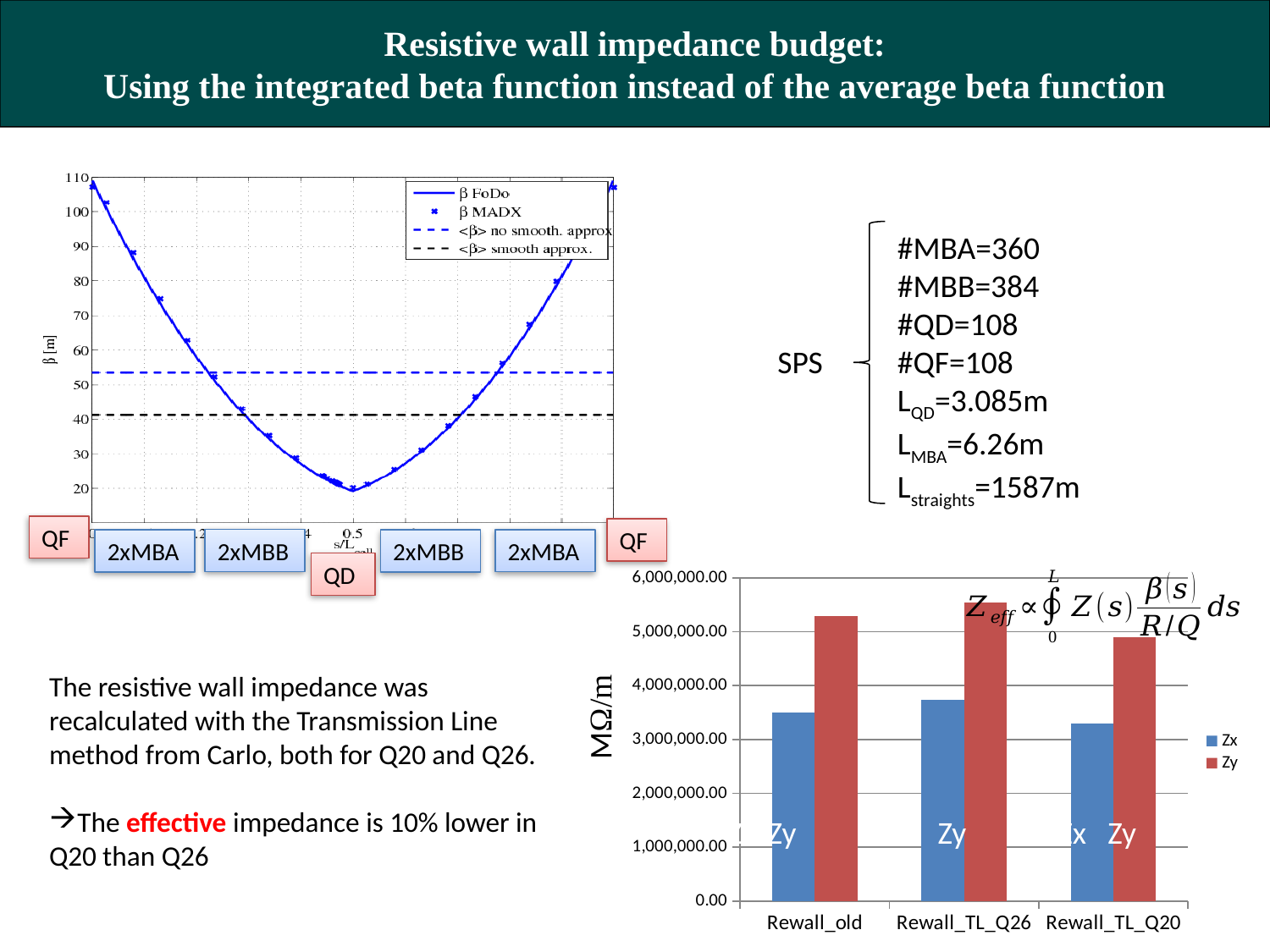
What kind of chart is the chart at the bottom right of the slide? bar chart In the bar chart at the bottom right, how many series does the legend list? 2 In the bar chart at the bottom right, which category has the lowest Zy value? Rewall_TL_Q20 In the line chart at the top left, does the β FoDo curve rise or fall as s/L goes from 0 to 0.5? fall In the bar chart at the bottom right, which category has the highest Zx value? Rewall_TL_Q26 In the line chart at the top left, how many entries does the legend list? 4 In the bar chart at the bottom right, how many categories are shown on the x axis? 3 In the bar chart at the bottom right, which is larger for Rewall_old, Zx or Zy? Zy In the bar chart at the bottom right, is the Zy value for Rewall_old greater or less than 5,000,000.00? greater In the bar chart at the bottom right, which category has the highest Zy value? Rewall_TL_Q26 In the bar chart at the bottom right, what is the label on the y axis? MΩ/m In the bar chart at the bottom right, is the Zx value for Rewall_TL_Q26 greater or less than 4,000,000.00? less